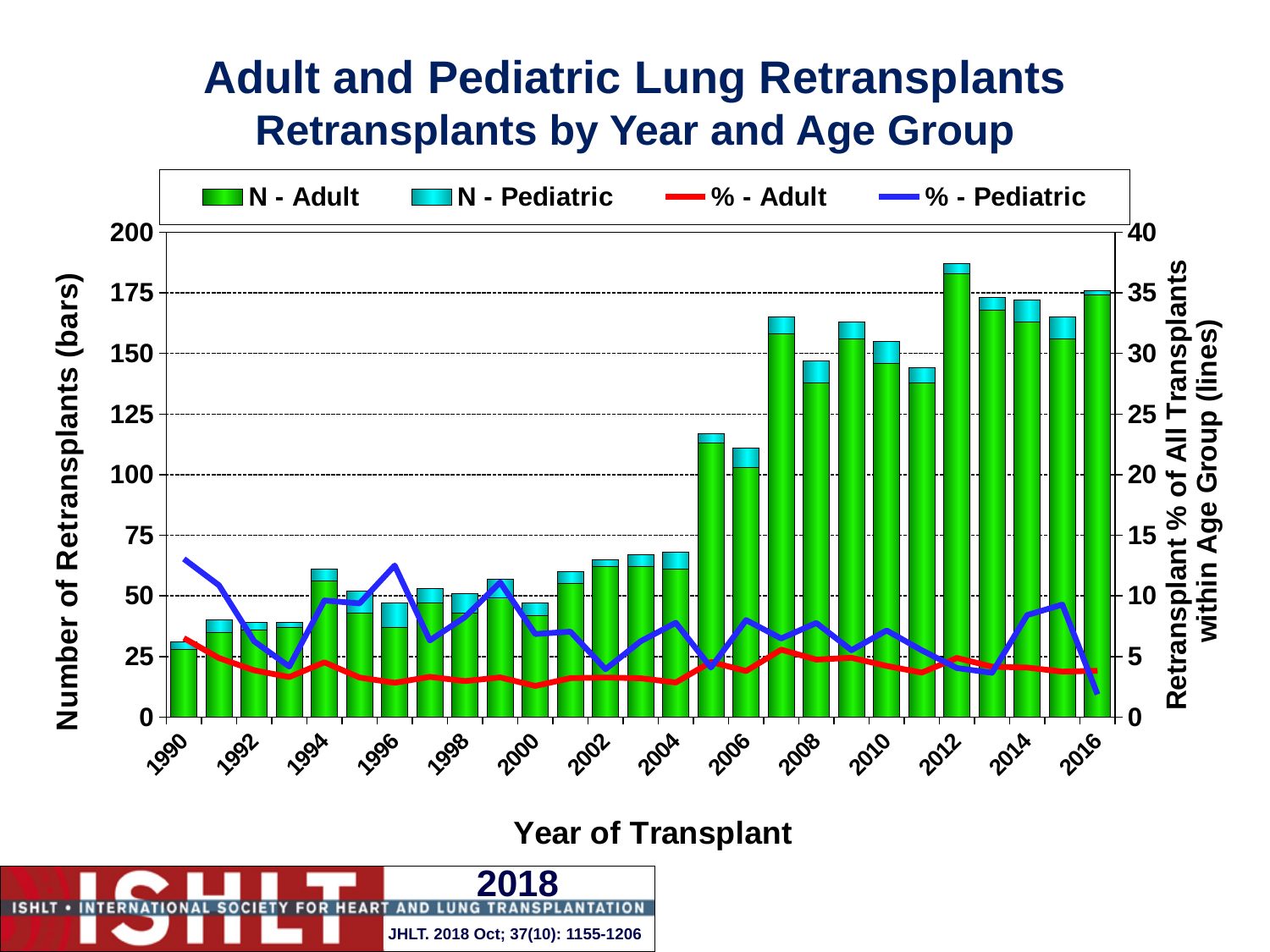
What is the title of the right-hand vertical axis? Retransplant % of All Transplants within Age Group (lines) Overall, do the bars for number of retransplants rise or fall from 1990 to 2016? rise In which year is the % - Pediatric line at its lowest point? 2016 Which year has the tallest bar for total number of retransplants? 2012 Is the total number of retransplants in 2012 greater or less than 175? greater Is the total number of retransplants in 2005 greater or less than 100? greater Which year has a taller bar, 2011 or 2012? 2012 What kind of chart is shown on the slide? A combination bar and line chart How many series does the legend list? 4 Which year has the shortest bar for total number of retransplants? 1990 Is the total number of retransplants in 1990 greater or less than 50? less